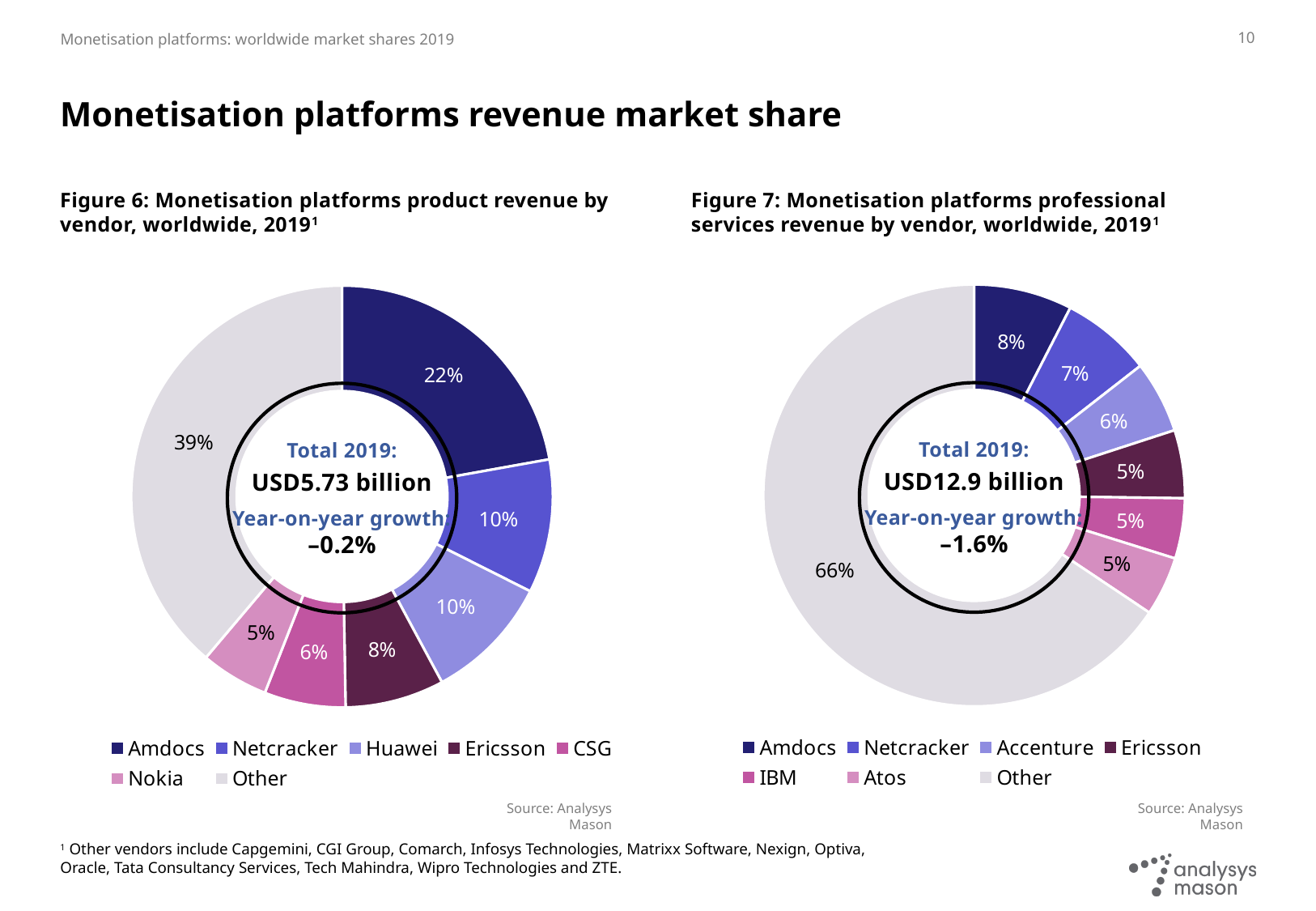
In Figure 6 (product revenue by vendor), which named vendor has the largest share? Amdocs What kind of chart is used in Figure 7? Donut (pie) chart In Figure 7 (professional services revenue by vendor), what share does Netcracker hold? 7% In Figure 6 (product revenue by vendor), what share does the Other category hold? 39% In Figure 7 (professional services revenue by vendor), which named vendor has the largest share? Amdocs In Figure 7 (professional services revenue by vendor), which is larger, Amdocs's share or Accenture's share? Amdocs In Figure 6 (product revenue by vendor), what share does Amdocs hold? 22% In Figure 6 (product revenue by vendor), how many categories are shown in the legend? 7 In Figure 6 (product revenue by vendor), what is the difference between Amdocs's share and Ericsson's share? 14 percentage points What total 2019 value is shown in the centre of Figure 7? USD12.9 billion In Figure 6 (product revenue by vendor), which named vendor has the smallest share? Nokia In Figure 7 (professional services revenue by vendor), what share does the Other category hold? 66%